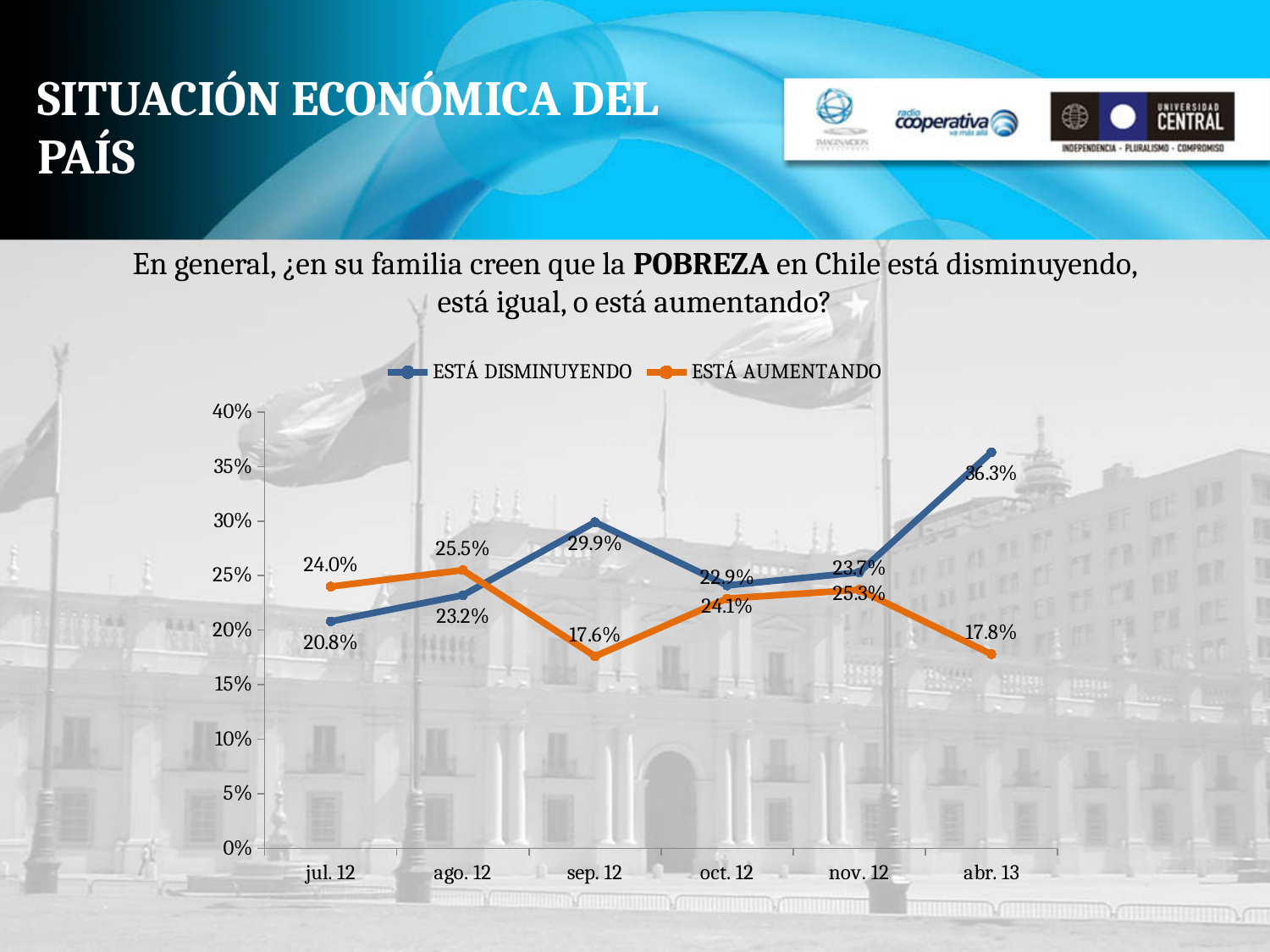
Which series has the larger value in ago. 12, ESTÁ DISMINUYENDO or ESTÁ AUMENTANDO? ESTÁ AUMENTANDO Is the value for ESTÁ DISMINUYENDO in abr. 13 greater or less than 35%? greater What is the difference between ESTÁ DISMINUYENDO and ESTÁ AUMENTANDO in abr. 13? 18.5% What is the value for ESTÁ DISMINUYENDO in jul. 12? 20.8% What is the value for ESTÁ AUMENTANDO in sep. 12? 17.6% In which month does ESTÁ AUMENTANDO reach its lowest value? sep. 12 What type of chart is shown on the slide? line chart Which colour is used for the ESTÁ AUMENTANDO series? orange What is the value for ESTÁ DISMINUYENDO in abr. 13? 36.3% How many series does the legend list? 2 How many time points are plotted along the x axis? 6 In which month does ESTÁ DISMINUYENDO reach its highest value? abr. 13